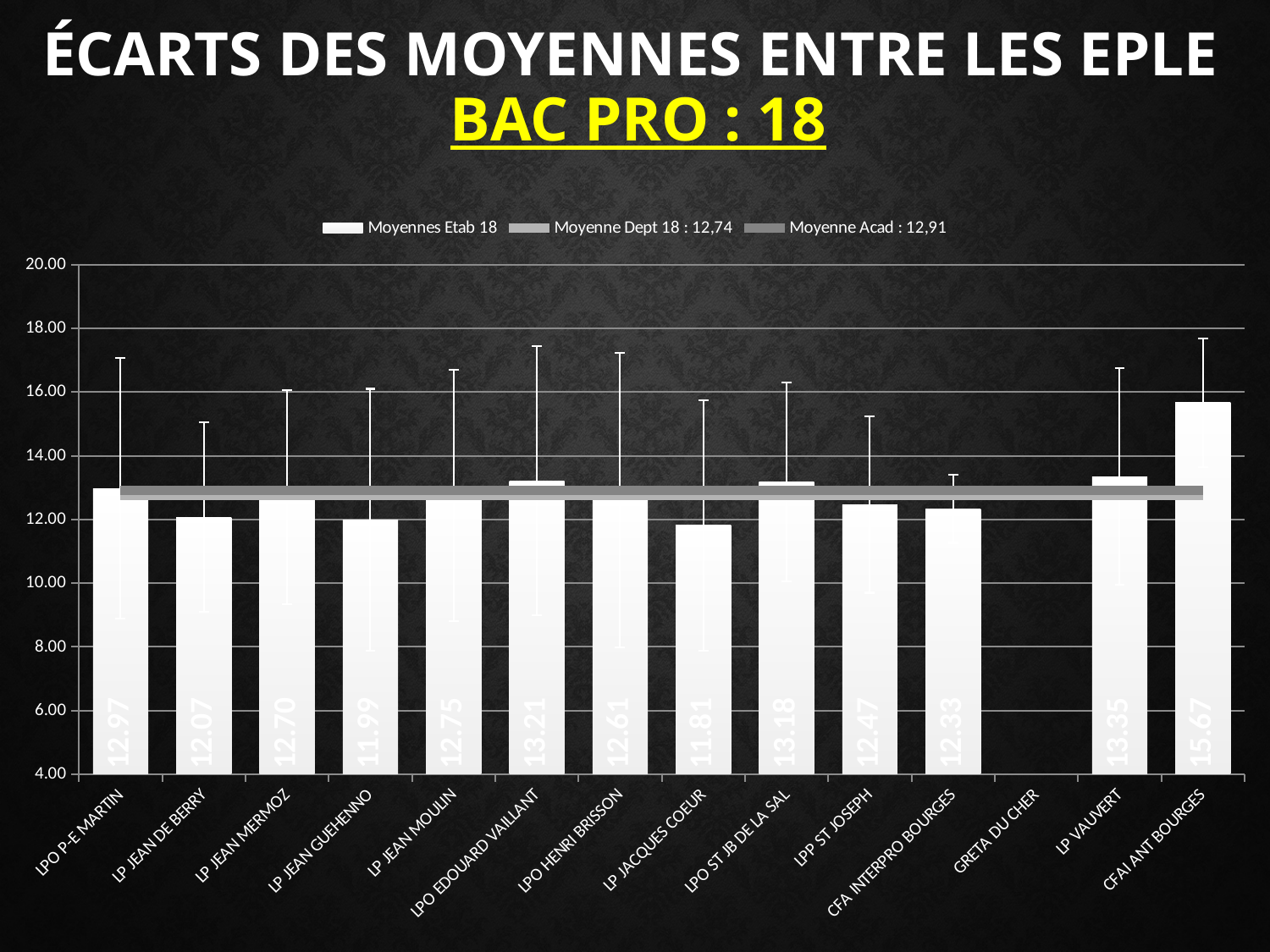
What is the value for LP JACQUES COEUR? 11.81 According to the legend, what is the value of Moyenne Dept 18? 12,74 Is the value for CFAI ANT BOURGES greater or less than 14.00? greater What kind of chart is shown on the slide? bar chart What is the difference between the values for CFAI ANT BOURGES and LP JACQUES COEUR? 3.86 What is the value for LPO P-E MARTIN? 12.97 How many series does the legend list? 3 Which is larger, the value for LP JEAN DE BERRY or the value for LP VAUVERT? LP VAUVERT What is the value for CFAI ANT BOURGES? 15.67 Which establishment has the highest value? CFAI ANT BOURGES Which establishment has the lowest plotted value? LP JACQUES COEUR How many establishments are listed on the x axis? 14